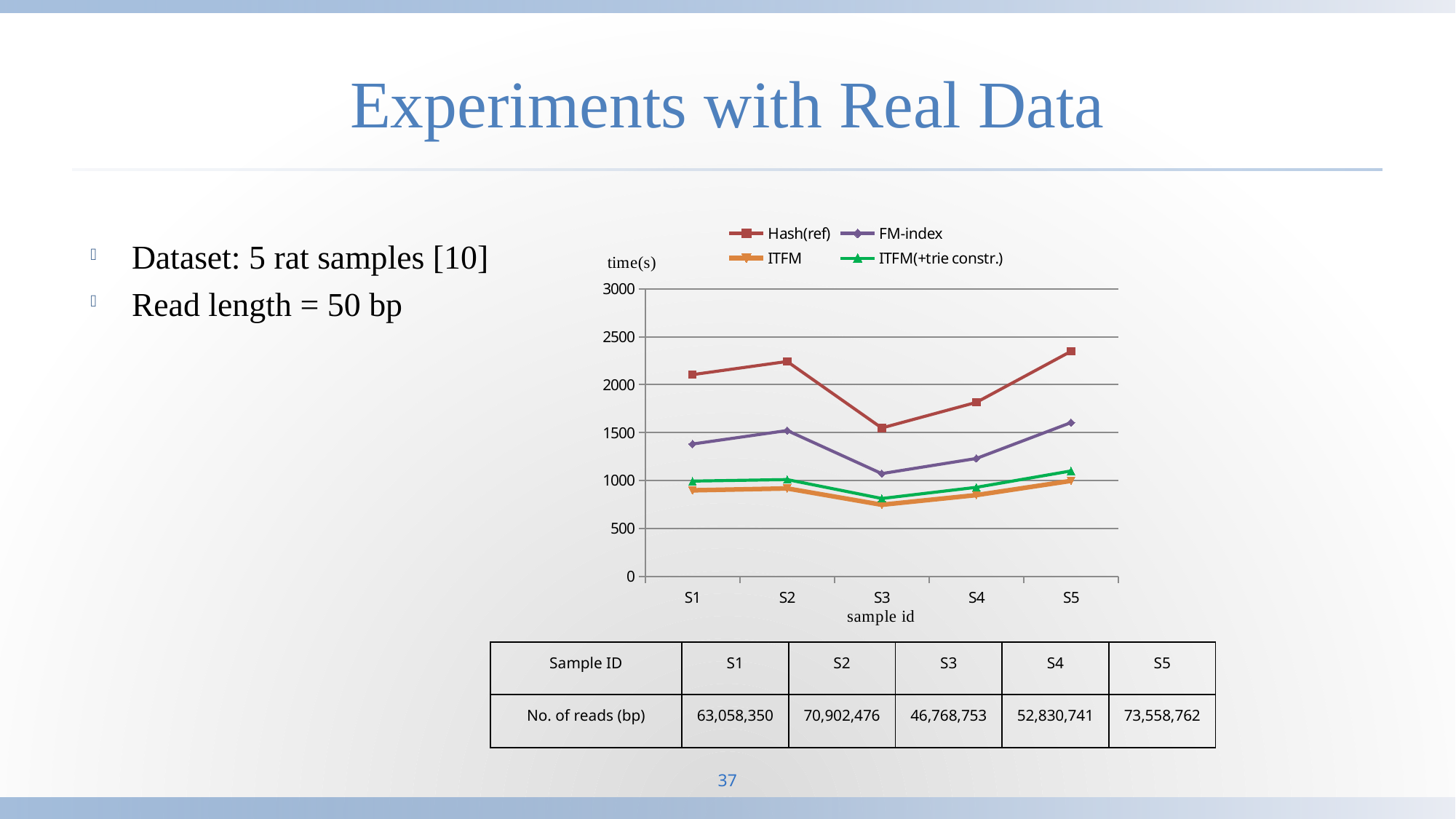
For which sample id is the Hash(ref) series highest? S5 For which sample id is the FM-index series lowest? S3 What is the label on the y axis of the chart? time(s) Does the Hash(ref) series rise or fall from S3 to S5? rise At S2, which series has the larger value: Hash(ref) or FM-index? Hash(ref) For which sample id is the Hash(ref) series lowest? S3 What kind of chart is shown on the slide? line chart How many sample ids are plotted along the x axis of the chart? 5 Is the ITFM value for S3 greater or less than 1000? less Is the FM-index value for S3 greater or less than 1500? less Is the Hash(ref) value for S1 greater or less than 2000? greater How many series does the chart's legend list? 4